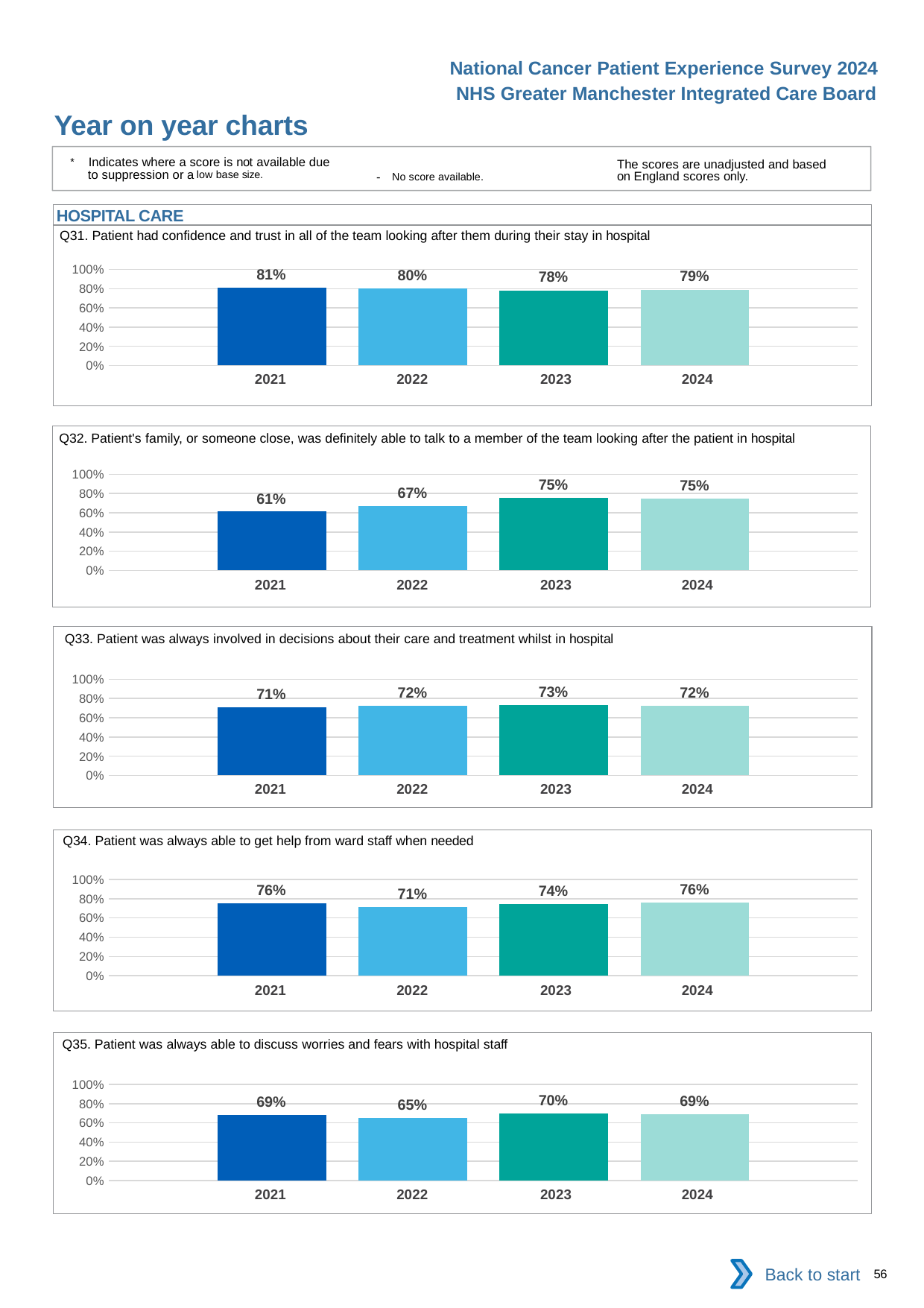
In the Q33 chart, which year has the highest value? 2023 In the Q32 chart, do the values rise or fall from 2021 to 2023? Rise In the Q34 chart, what is the value for 2022? 71% In the Q32 chart, what is the difference between the 2023 and 2021 values? 14 percentage points How many charts are shown on the slide? 5 In the Q35 chart, what is the value for 2023? 70% In the Q32 chart, which year has the lowest value? 2021 In the Q34 chart, which is larger, the value for 2021 or the value for 2023? 2021 How many years are shown in the Q31 chart? 4 In the Q35 chart, what is the difference between the 2021 and 2022 values? 4 percentage points In the Q31 chart, what is the value for 2021? 81% What kind of chart is the Q33 chart? Bar chart